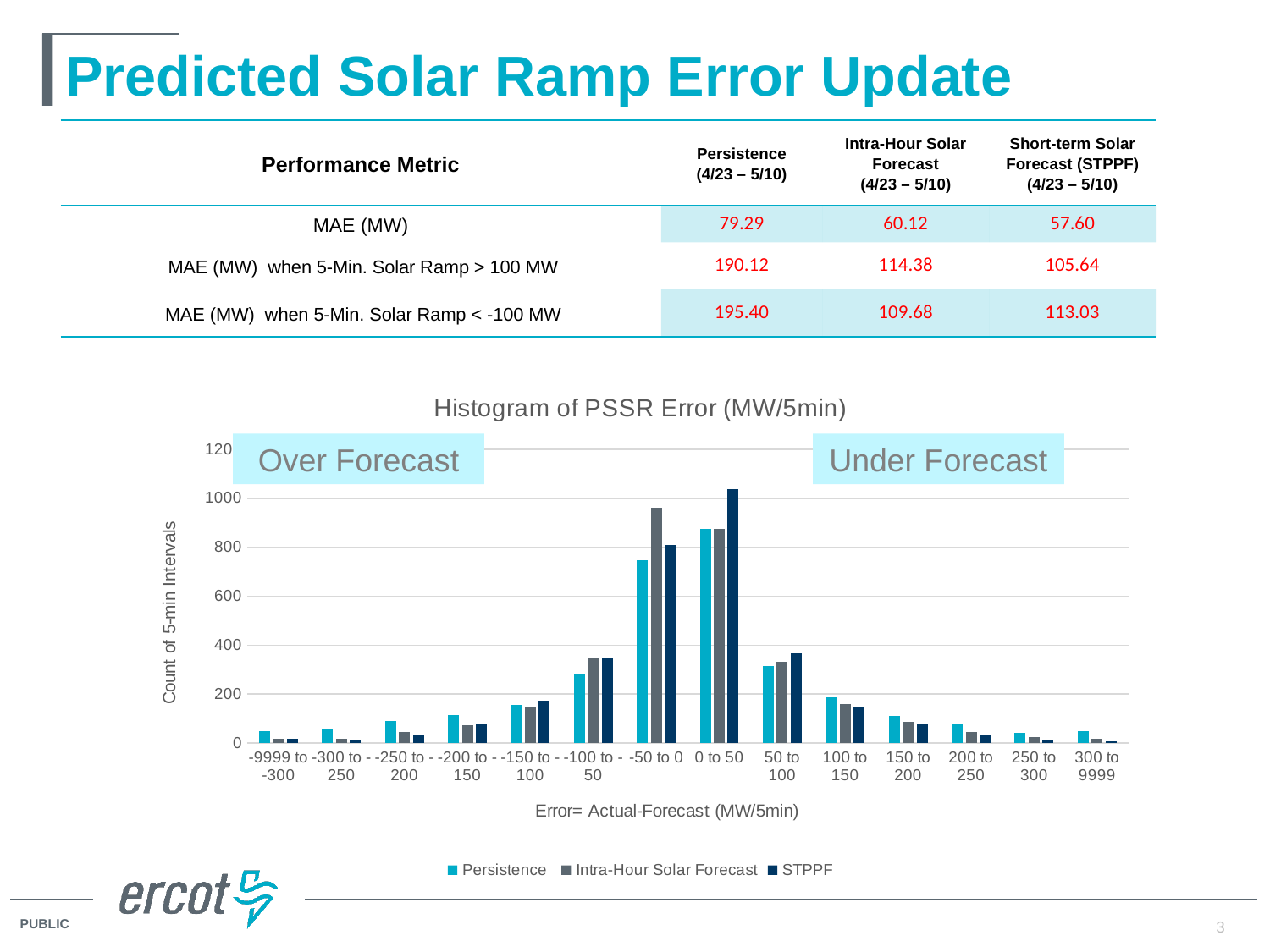
In the Histogram of PSSR Error chart, is the STPPF value for the 50 to 100 bin greater or less than 400? less What is the y-axis title of the Histogram of PSSR Error chart? Count of 5-min Intervals In the Histogram of PSSR Error chart, is the STPPF value for the 0 to 50 bin greater or less than 1000? greater In the Histogram of PSSR Error chart, is the Persistence value for the -50 to 0 bin greater or less than 800? less How many series does the legend of the Histogram of PSSR Error chart list? 3 In the Histogram of PSSR Error chart, which error bin has the highest Intra-Hour Solar Forecast count? -50 to 0 In the Histogram of PSSR Error chart, for the 0 to 50 bin, which is larger: Persistence or STPPF? STPPF What type of chart is the Histogram of PSSR Error (MW/5min)? bar chart In the Histogram of PSSR Error chart, which error bin has the highest STPPF count? 0 to 50 In the Histogram of PSSR Error chart, for the -50 to 0 bin, which is larger: Intra-Hour Solar Forecast or STPPF? Intra-Hour Solar Forecast How many error bins (categories) are shown on the x axis of the Histogram of PSSR Error chart? 14